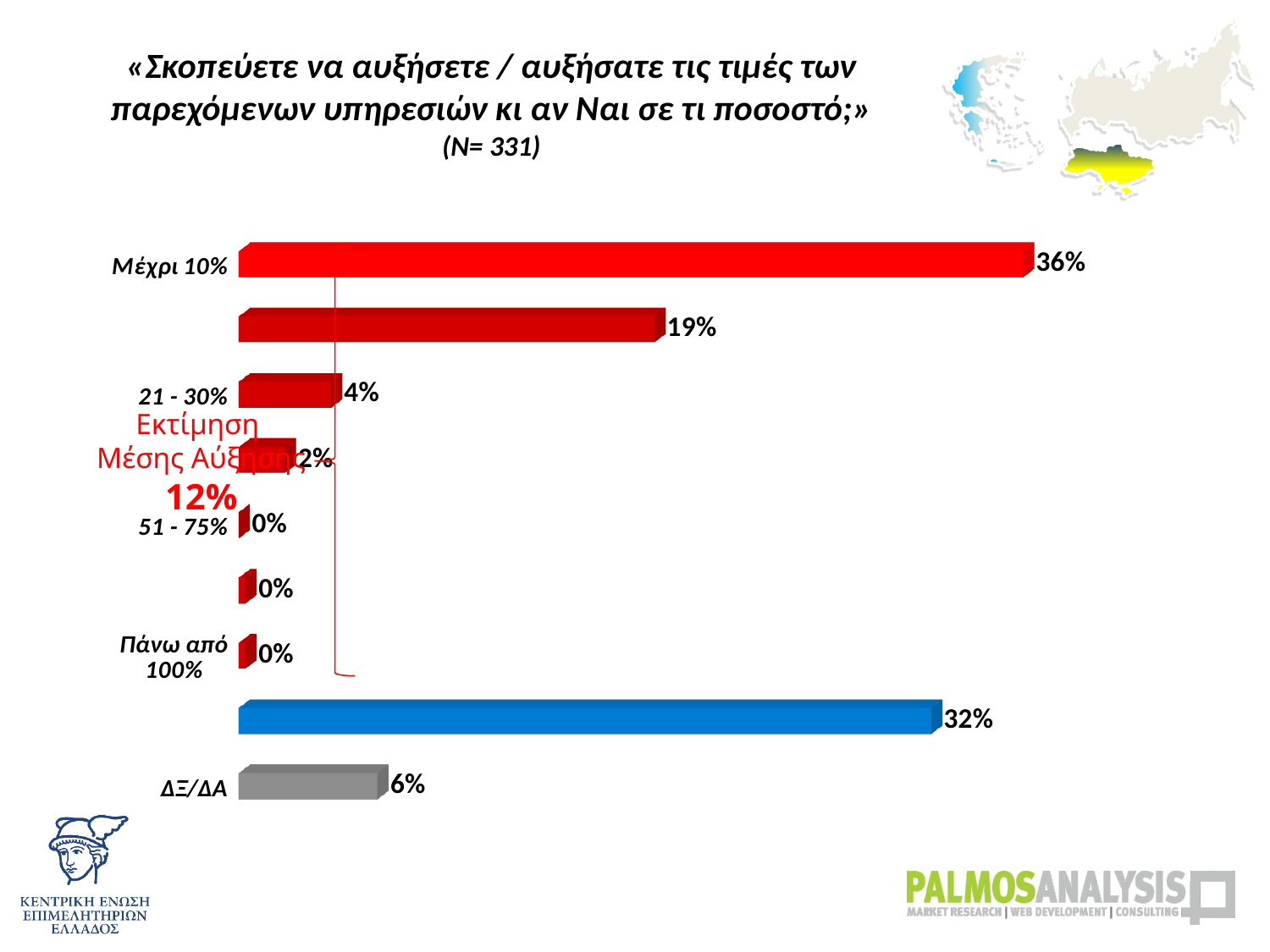
What percentage is shown for the category 'Πάνω από 100%'? 0% What percentage is shown for the category 'Μέχρι 10%'? 36% What percentage is shown for the category 'ΔΞ/ΔΑ'? 6% Which labelled category has the highest percentage? Μέχρι 10% Which is larger, the value for '21 - 30%' or the value for 'ΔΞ/ΔΑ'? ΔΞ/ΔΑ What percentage is shown for the category '21 - 30%'? 4% What type of chart is shown on the slide? Bar chart How many bars are plotted in the chart? 9 What percentage is shown for the category '51 - 75%'? 0% What is the difference in percentage points between 'Μέχρι 10%' and 'ΔΞ/ΔΑ'? 30 percentage points What value is labelled on the blue bar in the chart? 32% What is the difference in percentage points between 'ΔΞ/ΔΑ' and '21 - 30%'? 2 percentage points